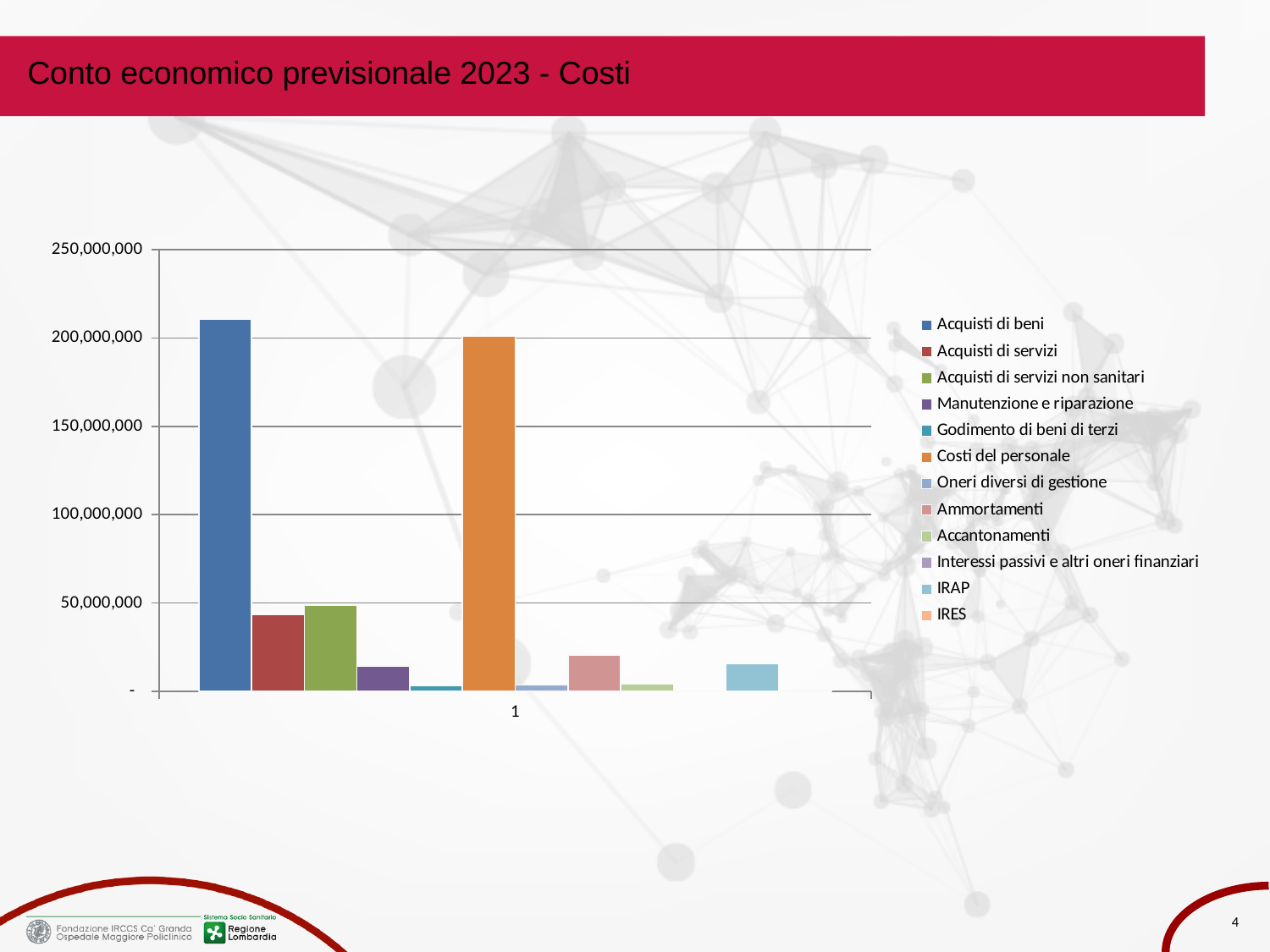
What is the title of the slide containing the chart? Conto economico previsionale 2023 - Costi Which series has the highest bar? Acquisti di beni Which is larger, the value for Ammortamenti or the value for Manutenzione e riparazione? Ammortamenti Which is larger, the value for Acquisti di beni or the value for Acquisti di servizi? Acquisti di beni Which is larger, the value for Costi del personale or the value for IRAP? Costi del personale What kind of chart is shown on the slide? bar chart How many series does the legend list? 12 Is the value for Acquisti di servizi greater or less than 50,000,000? less Is the value for Ammortamenti greater or less than 50,000,000? less Is the value for Costi del personale greater or less than 150,000,000? greater What colour is the bar for Costi del personale? orange